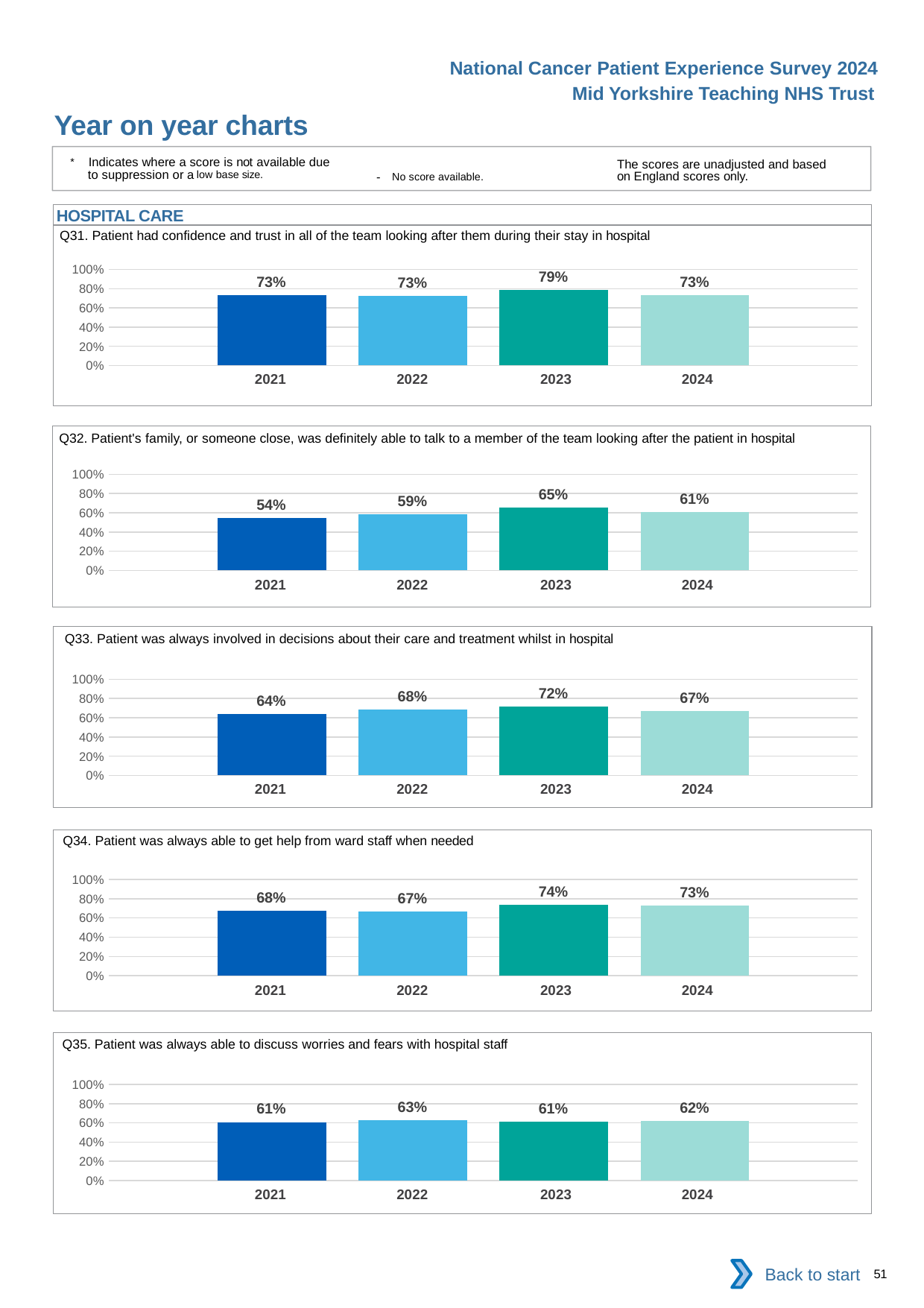
In the Q32 chart, do the values rise or fall from 2021 to 2023? rise In the Q34 chart, what is the value for 2024? 73% In the Q34 chart, which is larger, the value for 2021 or the value for 2022? 2021 In the Q32 chart, which year has the lowest value? 2021 How many years are shown on the x axis of the Q31 chart? 4 In the Q31 chart, what is the value for 2023? 79% In the Q35 chart, is the value for 2024 greater or less than 80%? less In the Q32 chart, what is the difference between the 2023 and 2024 values? 4 percentage points What kind of chart is the Q32 chart? bar chart In the Q33 chart, what is the value for 2021? 64% In the Q33 chart, which year has the highest value? 2023 In the Q35 chart, what is the value for 2022? 63%